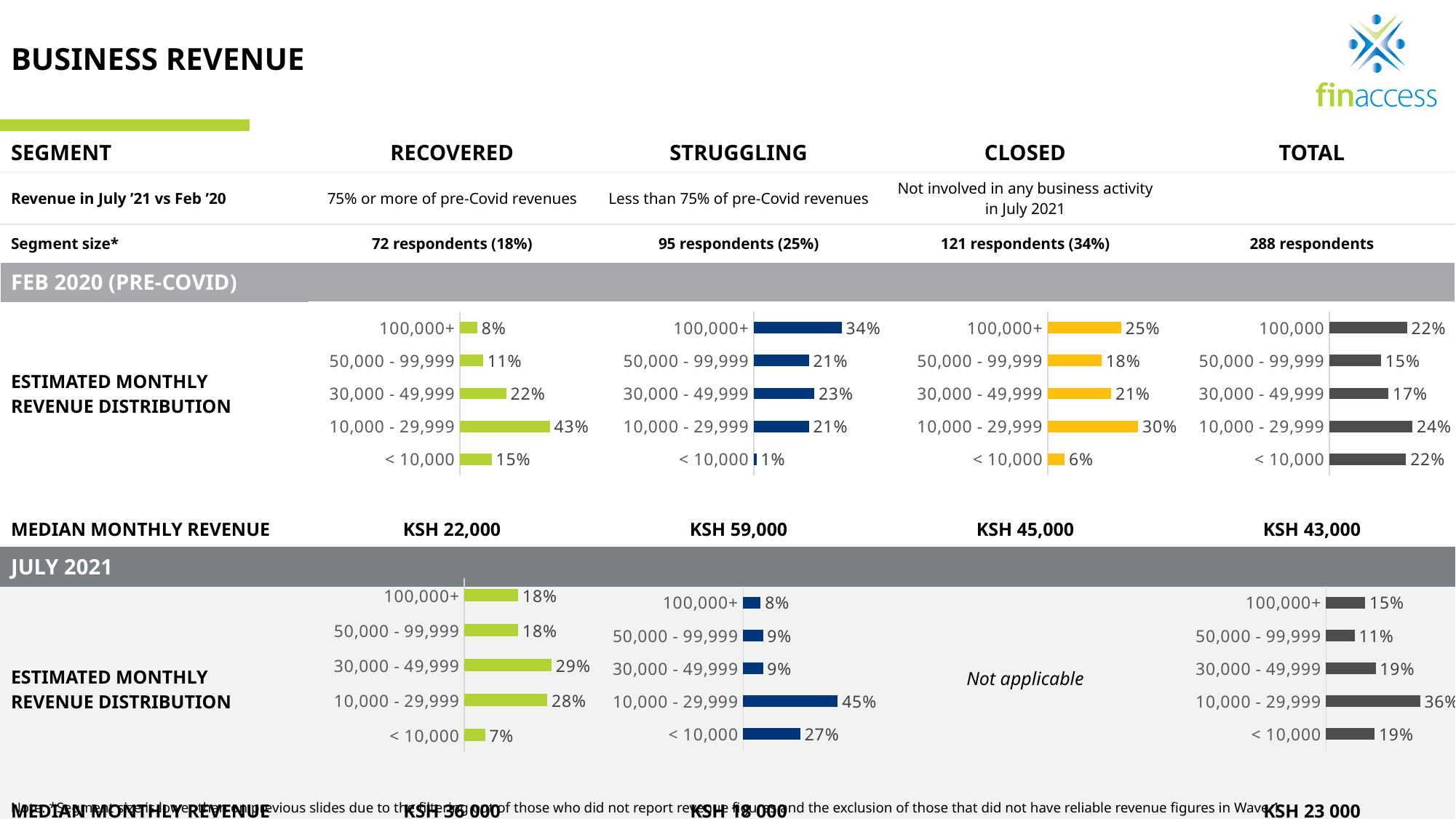
In the July 2021 chart for the Total column, what is the difference between the share for 10,000 - 29,999 and the share for 50,000 - 99,999? 25% In the Feb 2020 (pre-Covid) chart for the Struggling segment, what share of respondents had estimated monthly revenue of 100,000+? 34% In the July 2021 chart for the Recovered segment, which is larger: the share for 30,000 - 49,999 or the share for < 10,000? 30,000 - 49,999 In the July 2021 chart for the Struggling segment, what is the difference between the share for < 10,000 and the share for 100,000+? 19% What type of chart is used to show the estimated monthly revenue distribution for the Recovered segment in Feb 2020? Bar chart In the Feb 2020 (pre-Covid) chart for the Closed segment, which revenue band has the highest share? 10,000 - 29,999 In the Feb 2020 (pre-Covid) chart for the Struggling segment, which revenue band has the lowest share? < 10,000 In the July 2021 chart for the Struggling segment, what share of respondents had estimated monthly revenue of 10,000 - 29,999? 45% What is shown in place of a chart for the Closed segment in the July 2021 estimated monthly revenue distribution row? Not applicable In the Feb 2020 (pre-Covid) chart for the Closed segment, what share of respondents had estimated monthly revenue below 10,000? 6% How many revenue bands are shown in the Feb 2020 (pre-Covid) chart for the Total column? 5 In the Feb 2020 (pre-Covid) chart for the Recovered segment, what share of respondents had estimated monthly revenue of 10,000 - 29,999? 43%